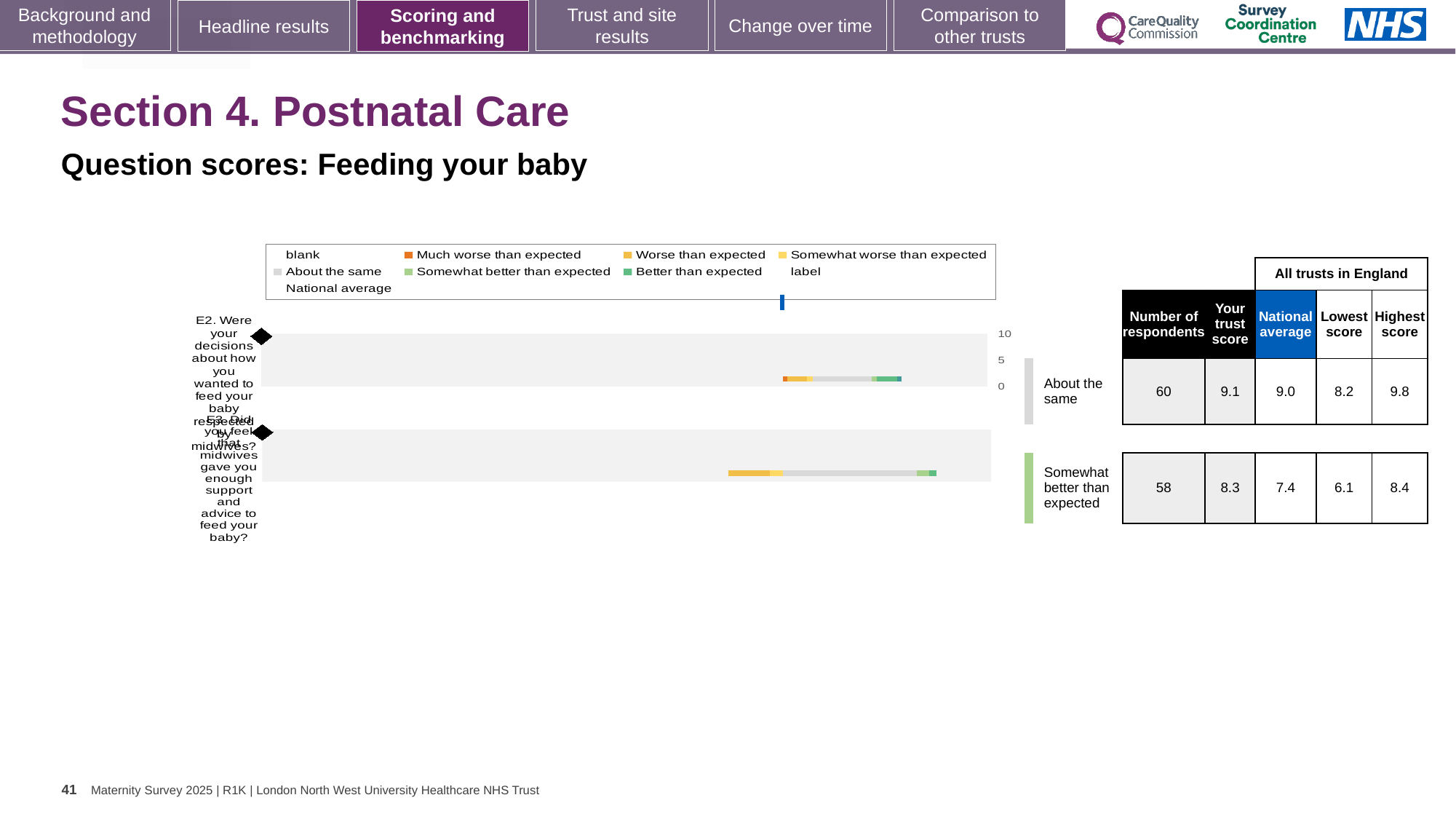
What is the trust score for question E2 (decisions about how you wanted to feed your baby respected by midwives)? 9.1 What is the national average for question E3? 7.4 Which benchmark category is question E2 placed in? About the same What is the highest score across all trusts in England for question E2? 9.8 What is the national average for question E2? 9.0 Which question has the higher trust score, E2 or E3? E2 How many respondents answered question E3? 58 What is the difference between the trust score and the national average for question E3? 0.9 What kind of chart is shown on the slide? bar chart How many questions are plotted in the chart? 2 What is the trust score for question E3 (midwives gave enough support and advice to feed your baby)? 8.3 Which benchmark category is question E3 placed in? Somewhat better than expected